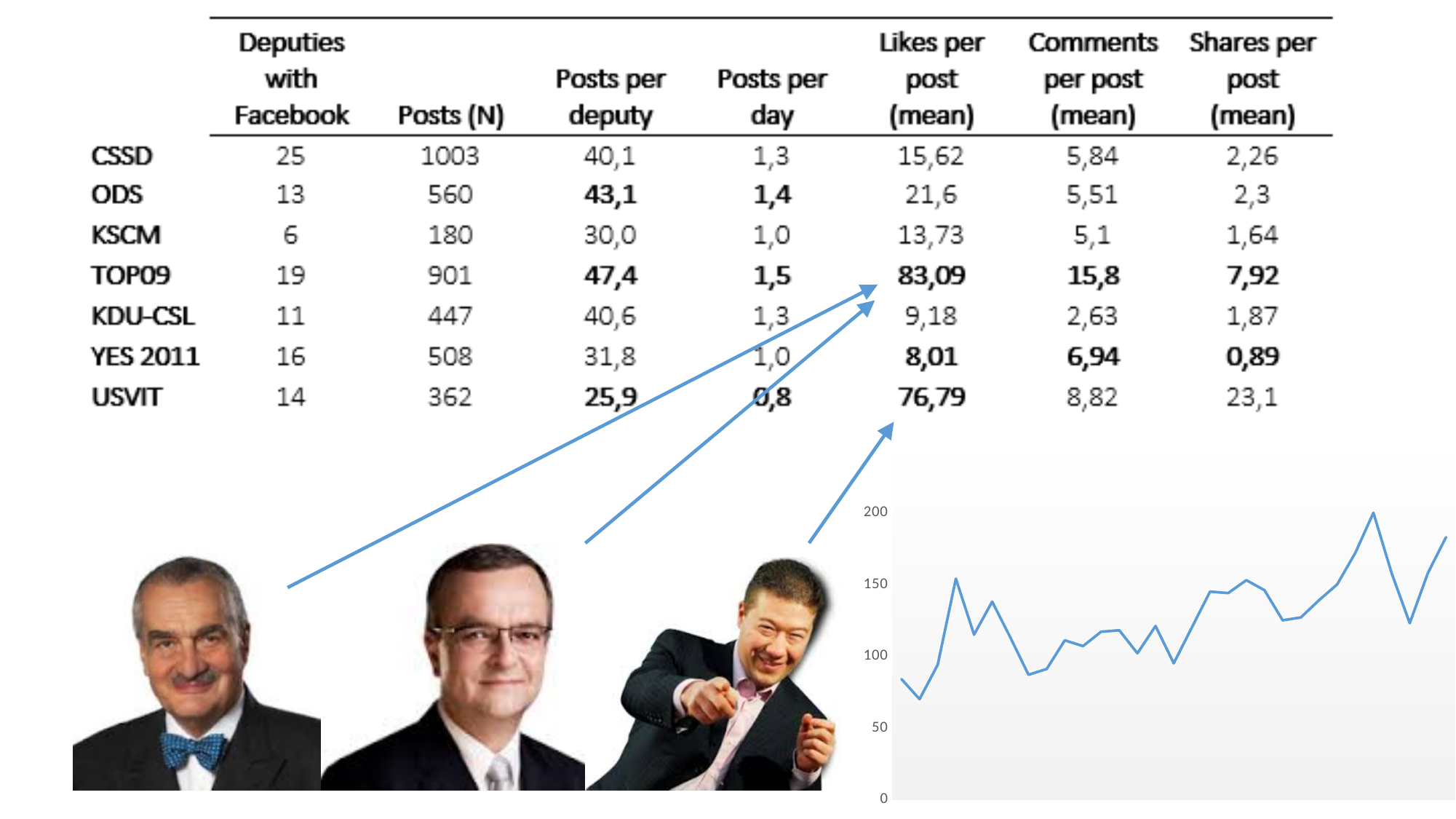
How many lines (series) are plotted in the line chart at the bottom right? 1 What colour is the line in the line chart at the bottom right? blue In the line chart at the bottom right, is the lowest point on the line greater or less than 100? less What is the highest value labelled on the vertical axis of the line chart at the bottom right? 200 What kind of chart is shown at the bottom right of the slide? line chart In the line chart at the bottom right, is the first point on the line greater or less than 100? less In the line chart at the bottom right, do the values generally rise or fall from left to right? rise In the line chart at the bottom right, is the last point on the line greater or less than 150? greater In the line chart at the bottom right, is the last point on the line higher or lower than the first point? higher